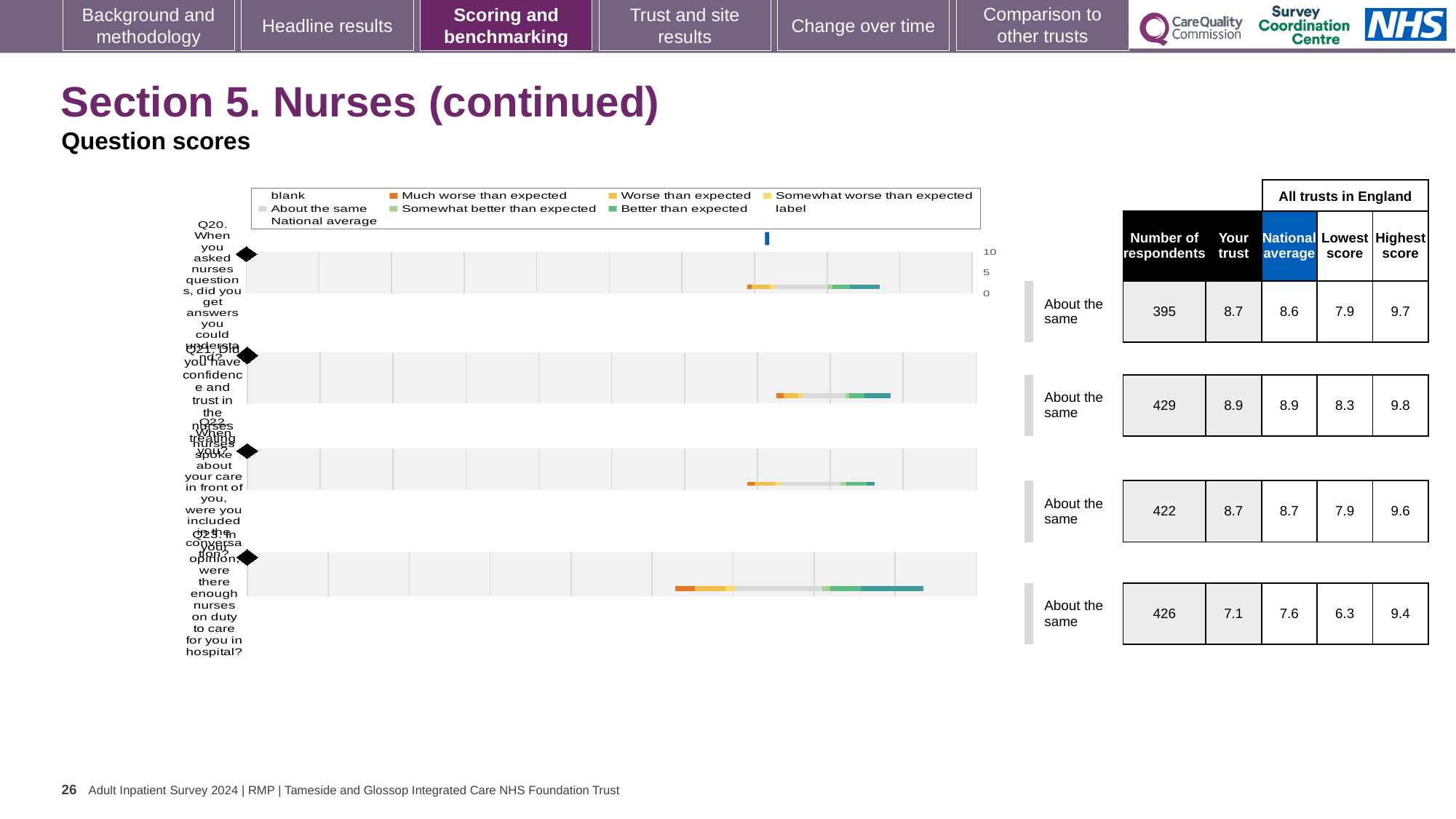
What is the highest score across all trusts in England for Q21? 9.8 What is the 'Your trust' score for Q20 (When you asked nurses questions, did you get answers you could understand?)? 8.7 What is the national average for Q23? 7.6 What is the difference between the highest score and the lowest score across all trusts in England for Q23? 3.1 What benchmark category is shown for Q22 (were you included in the conversation?)? About the same What is the 'Your trust' score for Q23 (were there enough nurses on duty to care for you in hospital?)? 7.1 How many respondents answered Q21 (Did you have confidence and trust in the nurses treating you?)? 429 Which question has the lowest 'Your trust' score? Q23 Which question has the highest 'Your trust' score? Q21 For Q20, which is larger: the 'Your trust' score or the national average? Your trust What kind of chart is shown on the slide? bar chart How many questions (categories) are plotted in the chart? 4